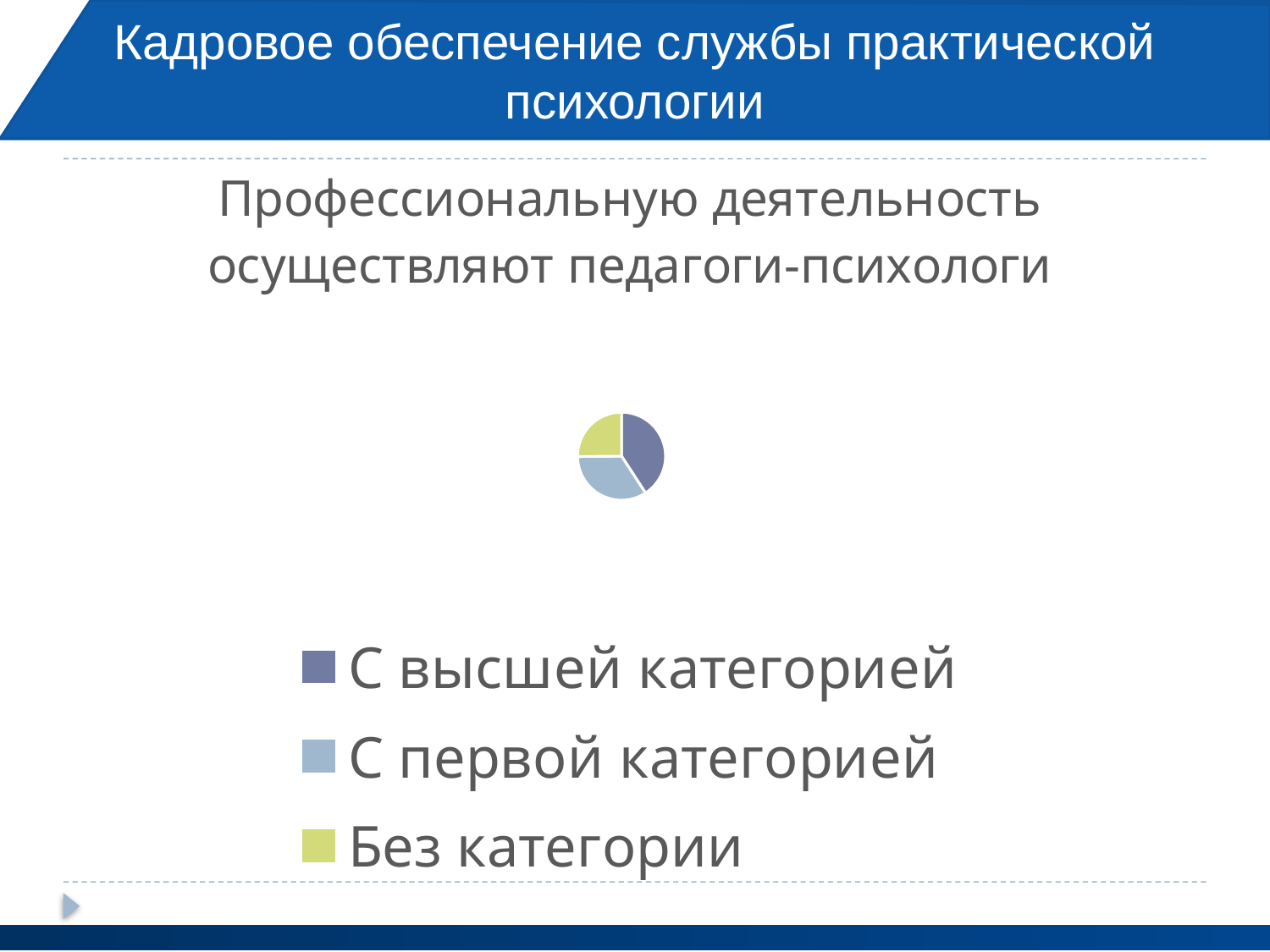
Which legend entry is shown in the dark blue colour? С высшей категорией What kind of chart is shown on the slide? pie chart How many slices does the pie chart have? 3 Which slice is larger: "С первой категорией" or "Без категории"? С первой категорией Which legend entry is shown in the yellow-green colour? Без категории How many entries does the legend of the pie chart list? 3 Which category has the smallest slice in the pie chart? Без категории Which slice is larger: "С высшей категорией" or "Без категории"? С высшей категорией